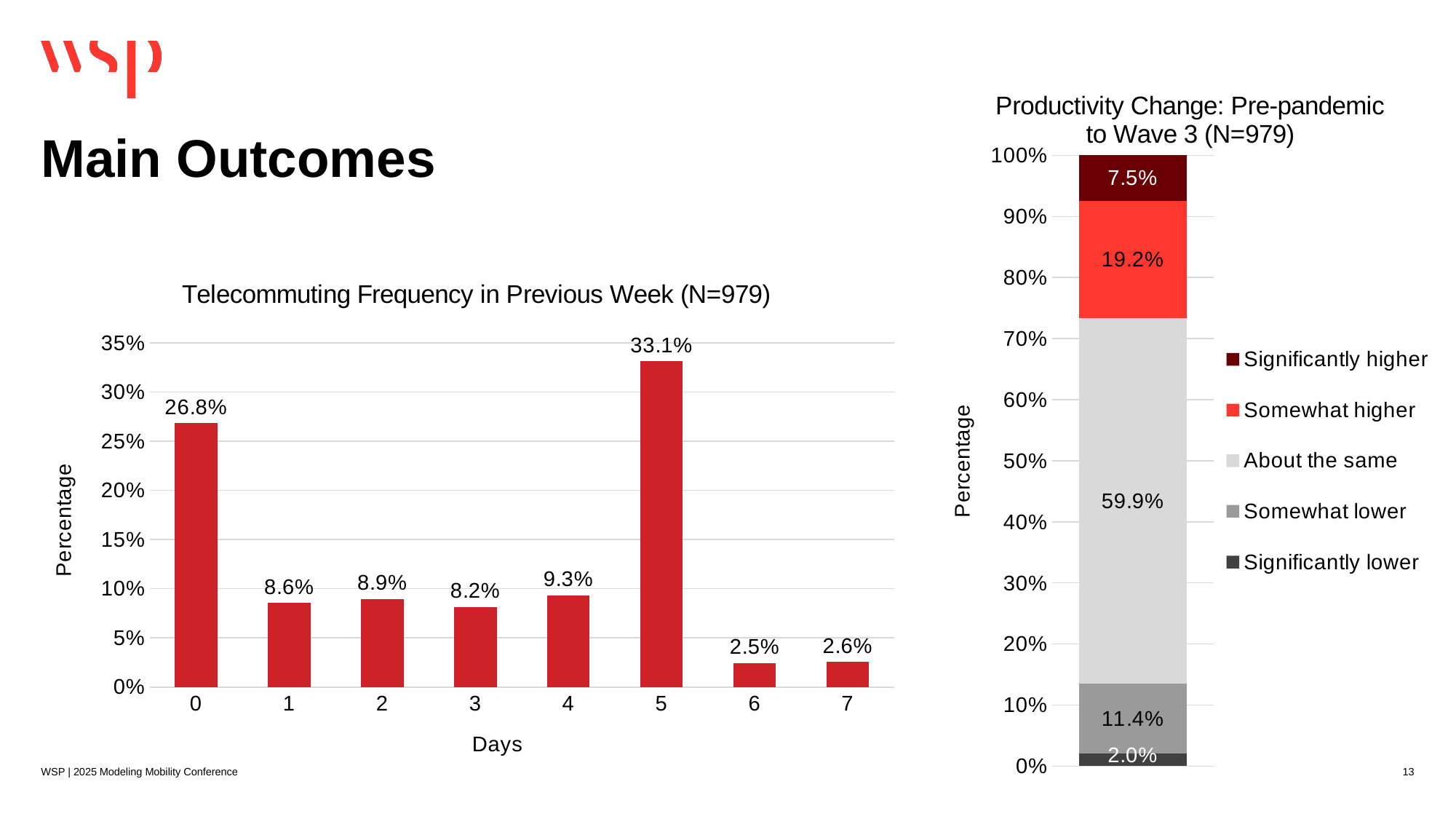
In the Productivity Change: Pre-pandemic to Wave 3 chart, what is the difference between the Somewhat higher and Somewhat lower percentages? 7.8% In the Telecommuting Frequency in Previous Week chart, which number of days has the lowest percentage? 6 In the Telecommuting Frequency in Previous Week chart, which number of days has the highest percentage? 5 In the Productivity Change: Pre-pandemic to Wave 3 chart, how many series does the legend list? 5 In the Telecommuting Frequency in Previous Week chart, what is the difference between the percentages for 5 days and 0 days? 6.3% In the Productivity Change: Pre-pandemic to Wave 3 chart, what percentage is labelled for About the same? 59.9% In the Telecommuting Frequency in Previous Week chart, how many day categories are shown on the x axis? 8 What kind of chart is the Telecommuting Frequency in Previous Week chart? Bar chart In the Telecommuting Frequency in Previous Week chart, which is larger, the percentage for 4 days or for 3 days? 4 days In the Telecommuting Frequency in Previous Week chart, what is the percentage for 0 days? 26.8% In the Telecommuting Frequency in Previous Week chart, what is the percentage for 5 days? 33.1% In the Productivity Change: Pre-pandemic to Wave 3 chart, what percentage is labelled for Significantly lower? 2.0%